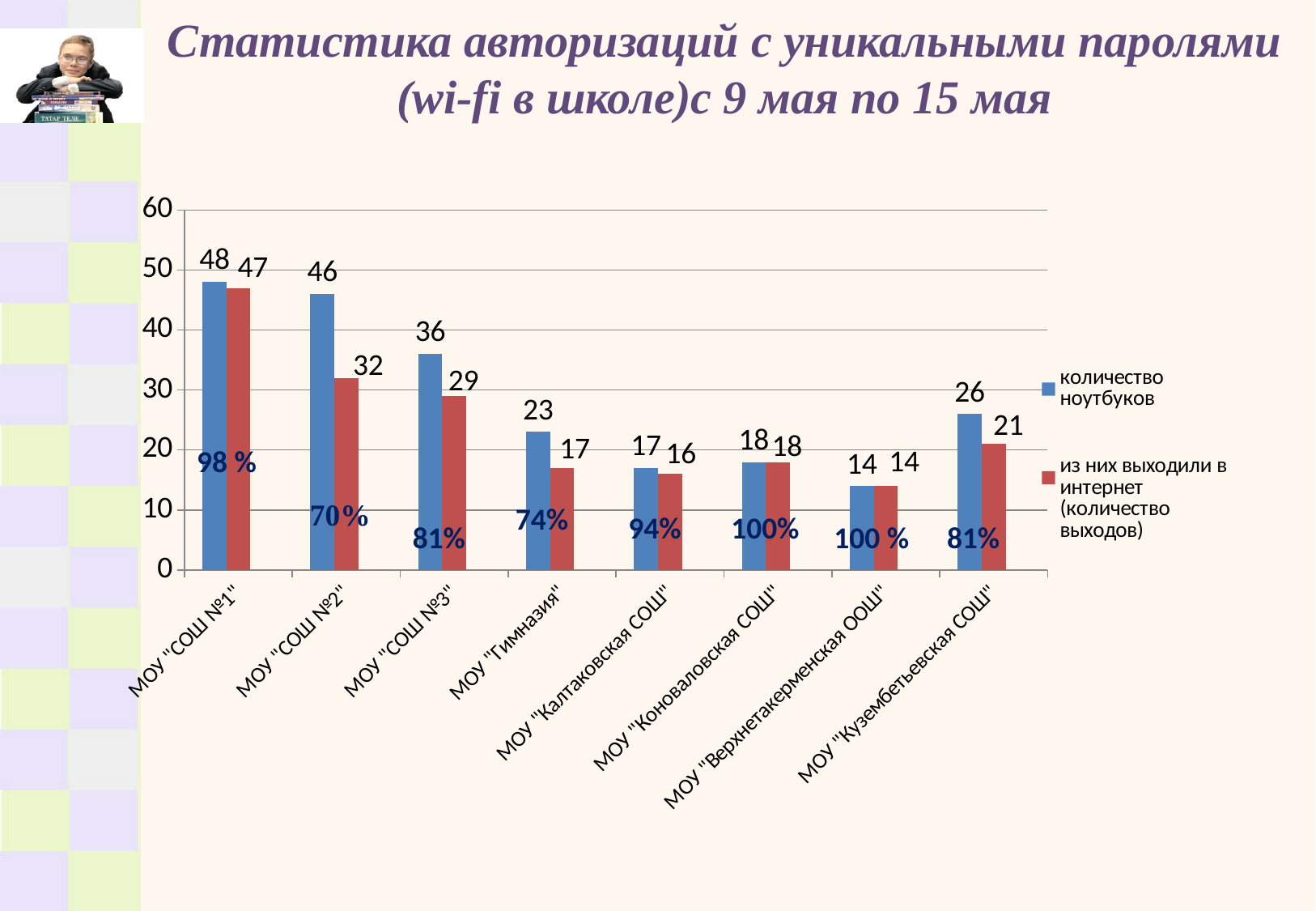
What percentage label is printed for МОУ "Коноваловская СОШ"? 100% What kind of chart is shown on the slide? bar chart What is the value of "количество ноутбуков" for МОУ "СОШ №2"? 46 Which is larger: "количество ноутбуков" for МОУ "СОШ №3" or for МОУ "Кузембетьевская СОШ"? МОУ "СОШ №3" What is the difference between "количество ноутбуков" and "из них выходили в интернет (количество выходов)" for МОУ "СОШ №2"? 14 What is the value of "из них выходили в интернет (количество выходов)" for МОУ "Гимназия"? 17 How many categories are shown on the x axis? 8 How many series does the legend list? 2 Which category has the lowest value for "из них выходили в интернет (количество выходов)"? МОУ "Верхнетакерменская ООШ" Which category has the highest value for "количество ноутбуков"? МОУ "СОШ №1" Is the value of "количество ноутбуков" for МОУ "Калтаковская СОШ" greater or less than 20? less What colour are the bars for the series "из них выходили в интернет (количество выходов)"? red